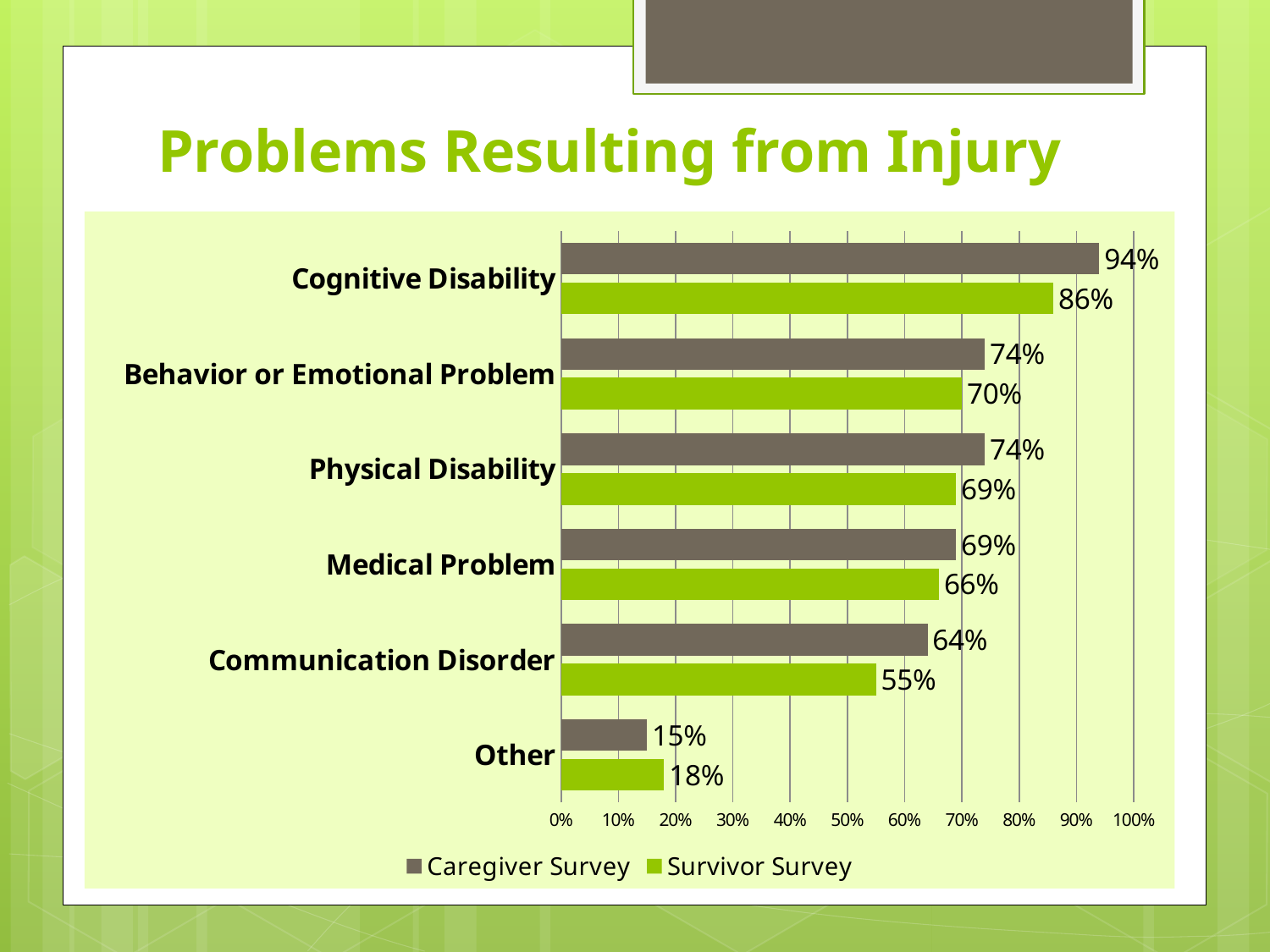
For Other, which survey reports the larger value, Caregiver Survey or Survivor Survey? Survivor Survey What is the title of the slide containing the chart? Problems Resulting from Injury What is the Survivor Survey value for Other? 18% Which category has the lowest Caregiver Survey value? Other What is the difference between the Caregiver Survey and Survivor Survey values for Communication Disorder? 9% What is the difference between the Caregiver Survey and Survivor Survey values for Cognitive Disability? 8% What is the Survivor Survey value for Communication Disorder? 55% What is the Caregiver Survey value for Cognitive Disability? 94% Which category has the highest Survivor Survey value? Cognitive Disability How many series does the legend list? 2 What kind of chart is shown on the slide? Bar chart How many categories are shown on the chart? 6